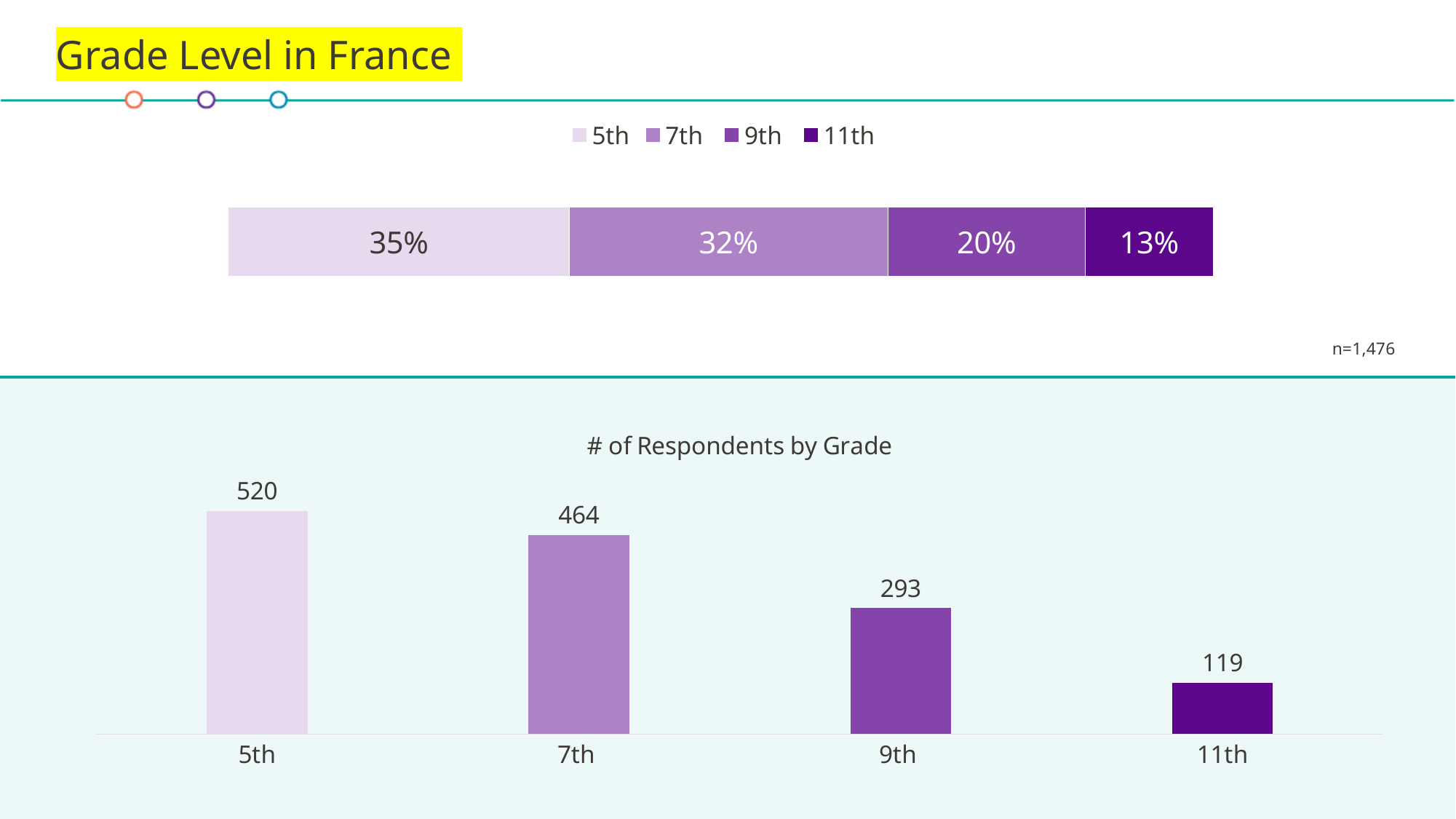
In the '# of Respondents by Grade' chart, which has more respondents, 7th or 9th grade? 7th In the top stacked bar chart, how many series does the legend list? 4 In the top stacked bar chart, what percentage is shown for 5th grade? 35% In the top stacked bar chart, which grade has the smallest share? 11th In the '# of Respondents by Grade' chart, how many respondents are in 9th grade? 293 In the '# of Respondents by Grade' chart, how many grade categories are shown? 4 In the '# of Respondents by Grade' chart, what is the difference between the 5th and 11th grade respondent counts? 401 In the '# of Respondents by Grade' chart, do the values rise or fall from 5th to 11th grade? fall In the '# of Respondents by Grade' chart, how many respondents are in 7th grade? 464 In the top stacked bar chart, what is the difference in percentage points between 7th and 9th grade? 12 In the top stacked bar chart, what percentage is shown for 11th grade? 13% In the '# of Respondents by Grade' chart, which grade has the most respondents? 5th